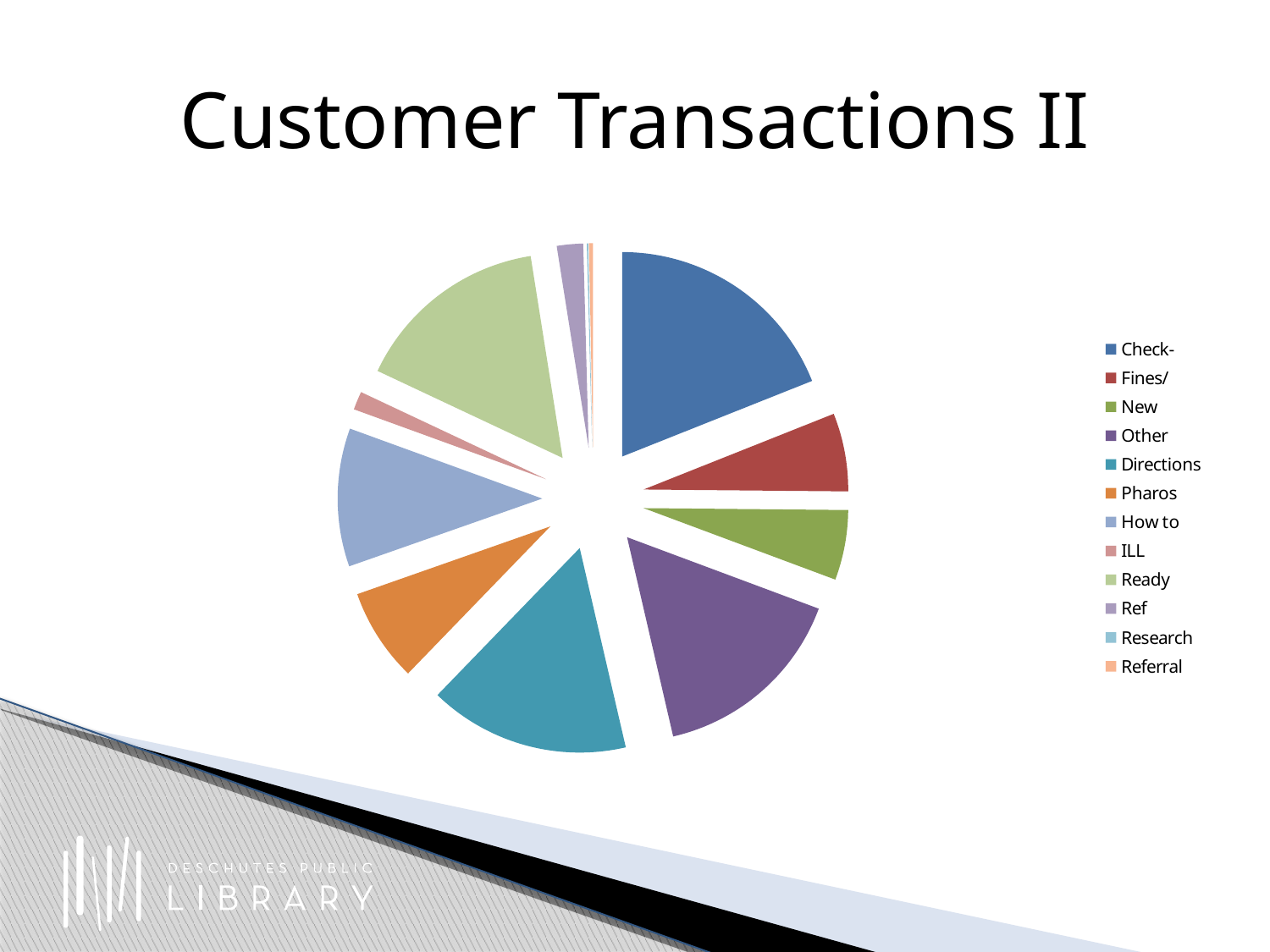
How many categories does the legend of the pie chart list? 12 Which category has the largest slice in the pie chart? Check- What kind of chart is shown on the slide? pie chart Which slice is larger, How to or Ref? How to Which legend entry is listed first in the pie chart's legend? Check- What is the title of the slide containing the pie chart? Customer Transactions II Which slice is larger, Ready or ILL? Ready Which slice is larger, Other or New? Other What colour is the Check- slice in the pie chart? blue